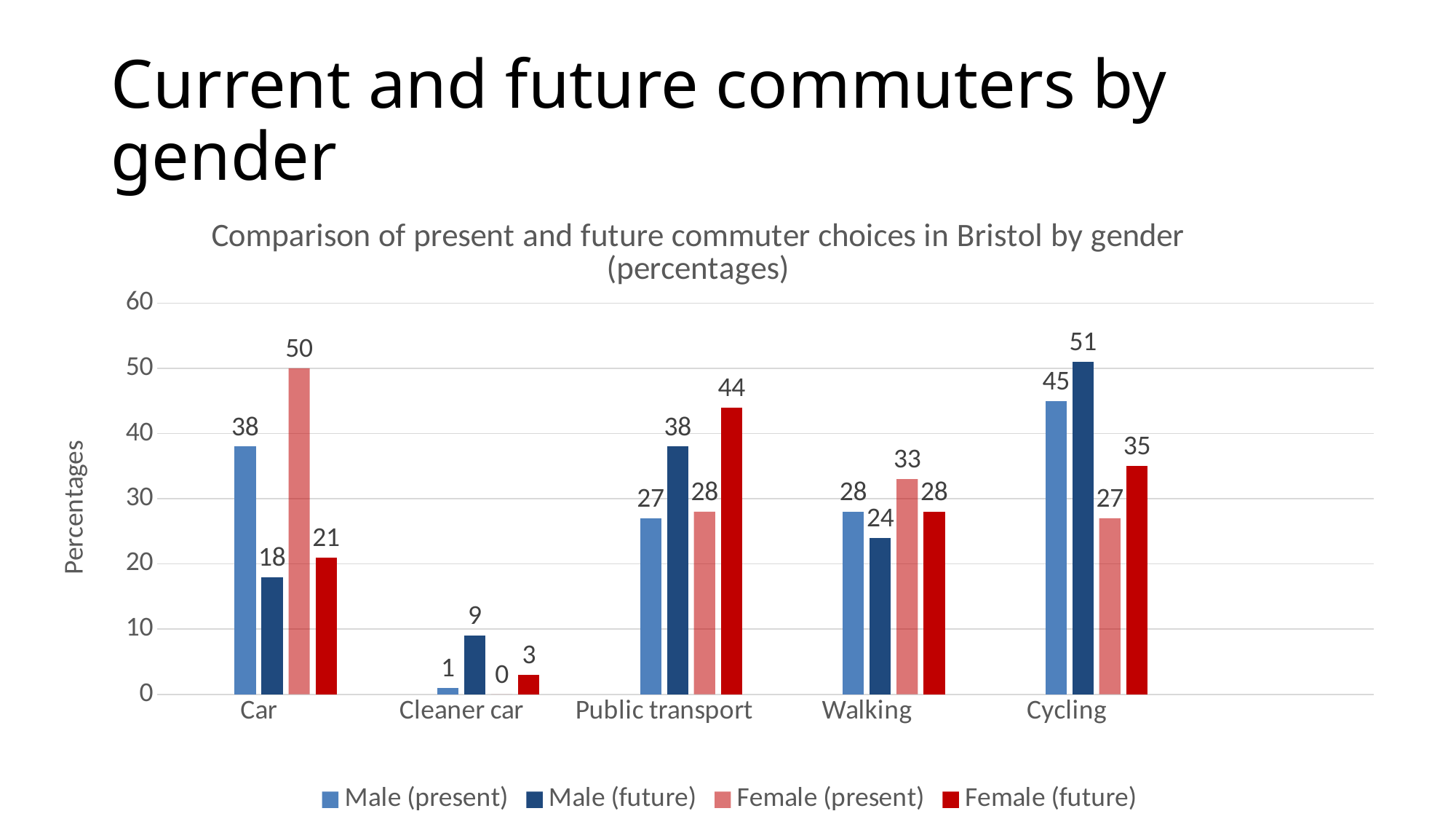
What is the title of the chart? Comparison of present and future commuter choices in Bristol by gender (percentages) How many categories are shown on the x axis? 5 Which category has the lowest Female (present) value? Cleaner car Which category has the highest Male (future) value? Cycling What is the difference between the Male (present) and Male (future) values for Car? 20 What is the Male (future) value for Cleaner car? 9 Which is larger for Walking: Female (present) or Female (future)? Female (present) What is the Female (present) value for Car? 50 What is the label on the vertical axis? Percentages How many series does the legend list? 4 What is the Female (future) value for Public transport? 44 What kind of chart is shown on the slide? Bar chart